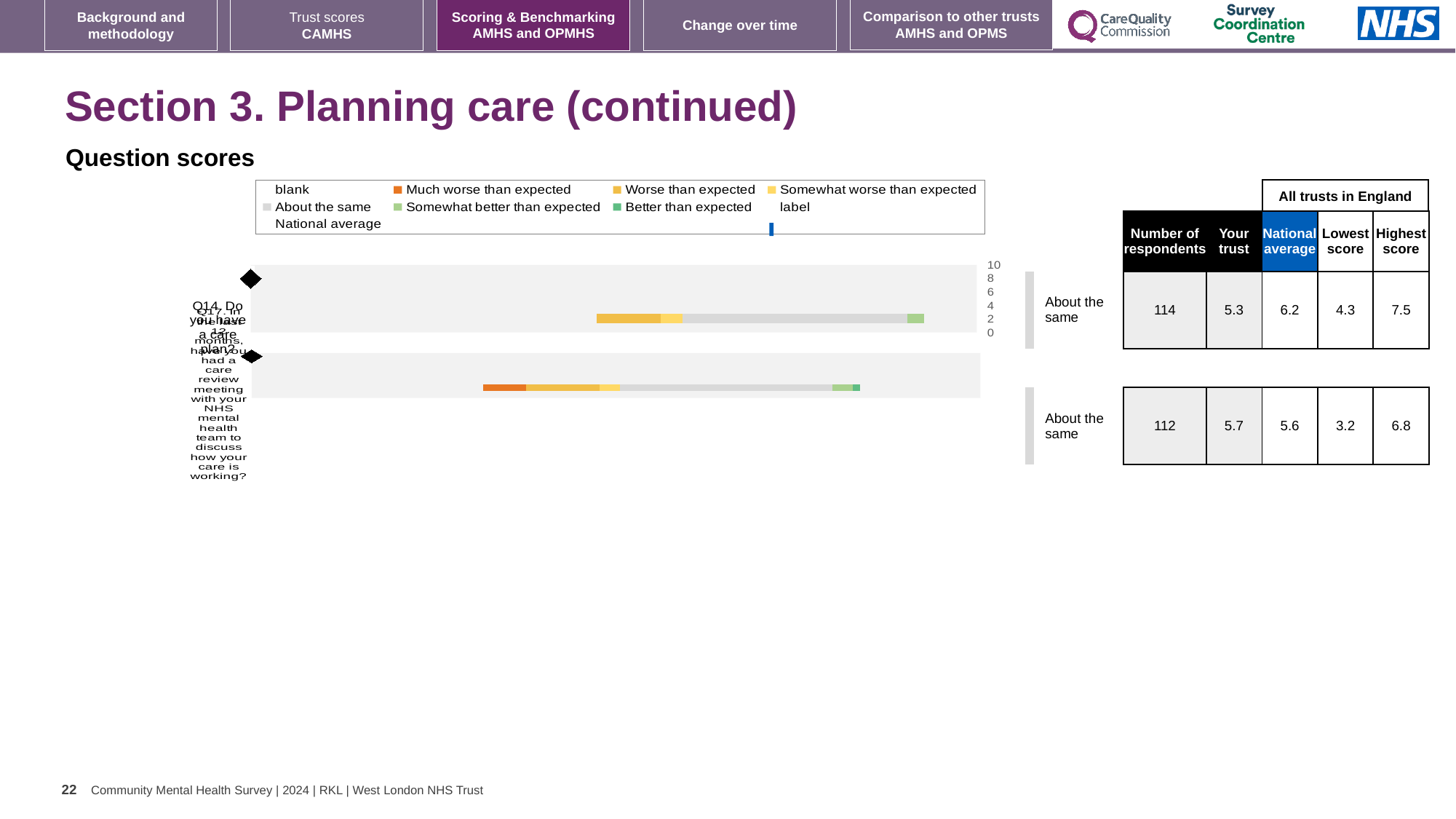
Which colour does the legend use for 'Much worse than expected'? orange What benchmark category is shown for Q17 (care review meeting)? About the same What is the difference between the highest score and the lowest score for Q14? 3.2 For Q17, which is larger: the 'Your trust' score or the national average? Your trust What is the highest score among all trusts in England for Q17? 6.8 What is the 'Your trust' score for Q14 (Do you have a care plan?)? 5.3 What is the national average score for Q14 (Do you have a care plan?)? 6.2 How many questions (categories) are plotted in the chart? 2 For Q14, which is larger: the 'Your trust' score or the national average? National average How many respondents answered Q17 (care review meeting in the last 12 months)? 112 What kind of chart is shown under 'Question scores'? bar chart Which colour does the legend use for 'Better than expected'? green